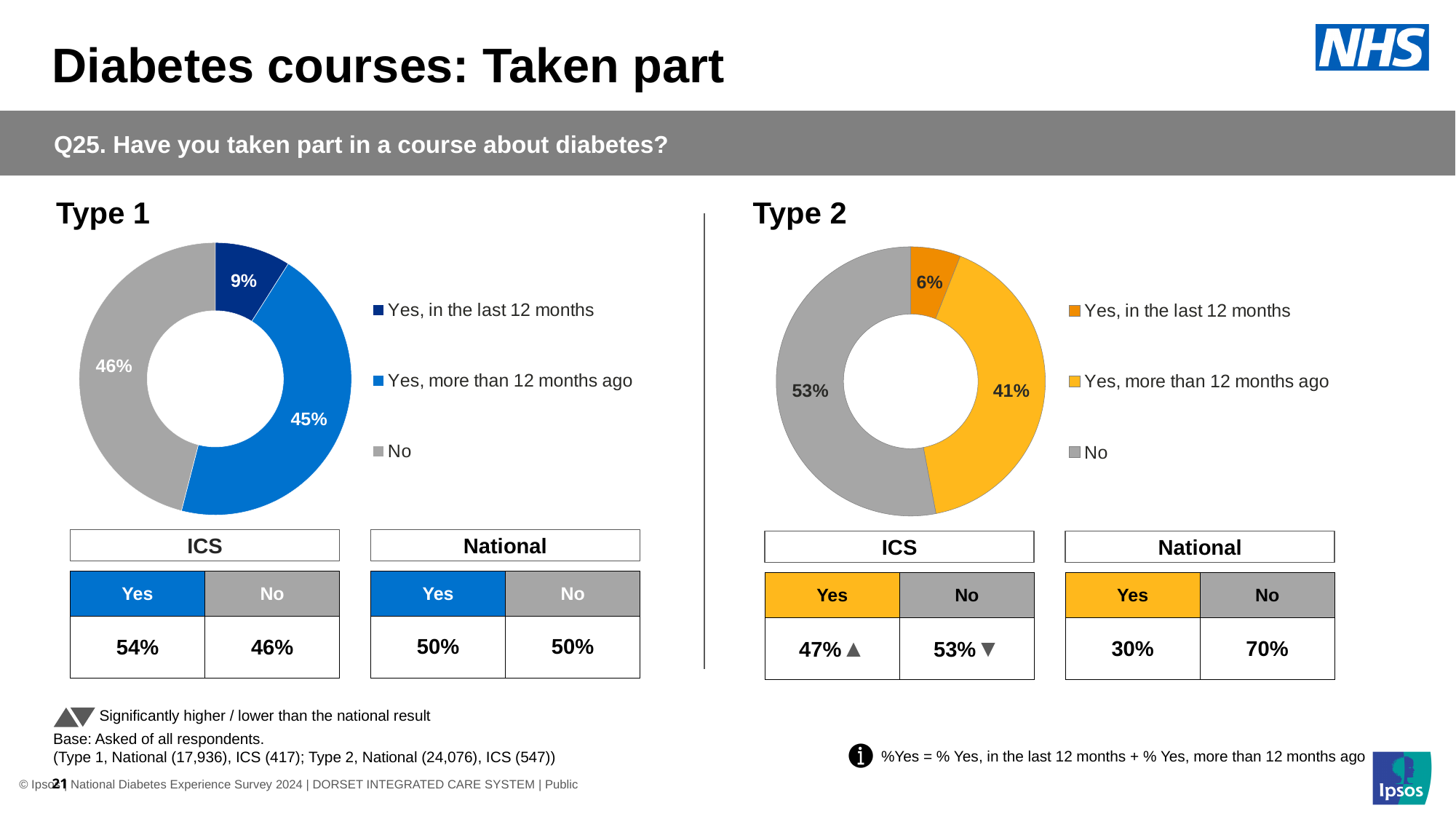
In the Type 1 chart, what is the combined share of the two 'Yes' categories? 54% In the Type 2 chart, what colour is the 'No' segment? Grey How many categories does the Type 1 chart show? 3 What kind of chart is used for Type 2? Doughnut chart In the Type 1 chart, which category has the largest share? No In the Type 1 chart, what percentage answered 'Yes, in the last 12 months'? 9% In the Type 2 chart, which category has the smallest share? Yes, in the last 12 months In the Type 2 chart, what percentage answered 'No'? 53% In the Type 1 chart, which is larger: 'Yes, more than 12 months ago' or 'Yes, in the last 12 months'? Yes, more than 12 months ago In the Type 2 chart, what is the difference between the 'No' share and the 'Yes, more than 12 months ago' share? 12% In the Type 2 chart, what percentage answered 'Yes, in the last 12 months'? 6% In the Type 1 chart, what percentage answered 'Yes, more than 12 months ago'? 45%